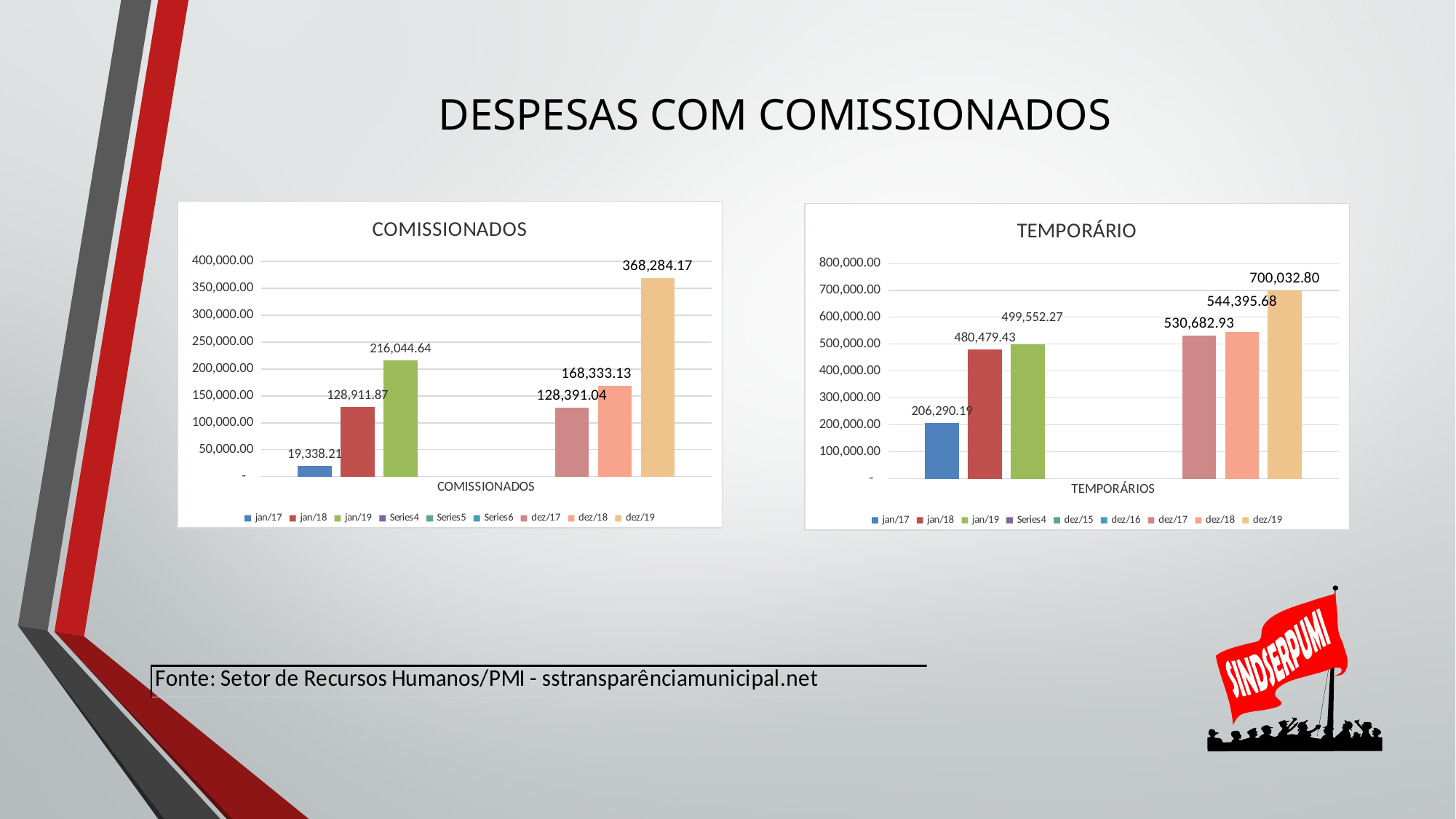
In the COMISSIONADOS chart, which is larger, the value for jan/19 or the value for dez/18? jan/19 In the COMISSIONADOS chart, what is the difference between the dez/19 value and the jan/19 value? 152,239.53 In the TEMPORÁRIO chart, which series has the lowest value? jan/17 In the COMISSIONADOS chart, what is the value for jan/17? 19,338.21 In the COMISSIONADOS chart, what is the value for dez/19? 368,284.17 In the TEMPORÁRIO chart, is the value for jan/19 greater or less than 400,000.00? greater In the TEMPORÁRIO chart, what is the difference between the dez/19 value and the dez/18 value? 155,637.12 In the COMISSIONADOS chart, which series has the highest value? dez/19 In the TEMPORÁRIO chart, what is the value for dez/17? 530,682.93 What kind of chart is the COMISSIONADOS chart? bar chart In the TEMPORÁRIO chart, what is the value for jan/18? 480,479.43 How many series does the legend of the TEMPORÁRIO chart list? 9